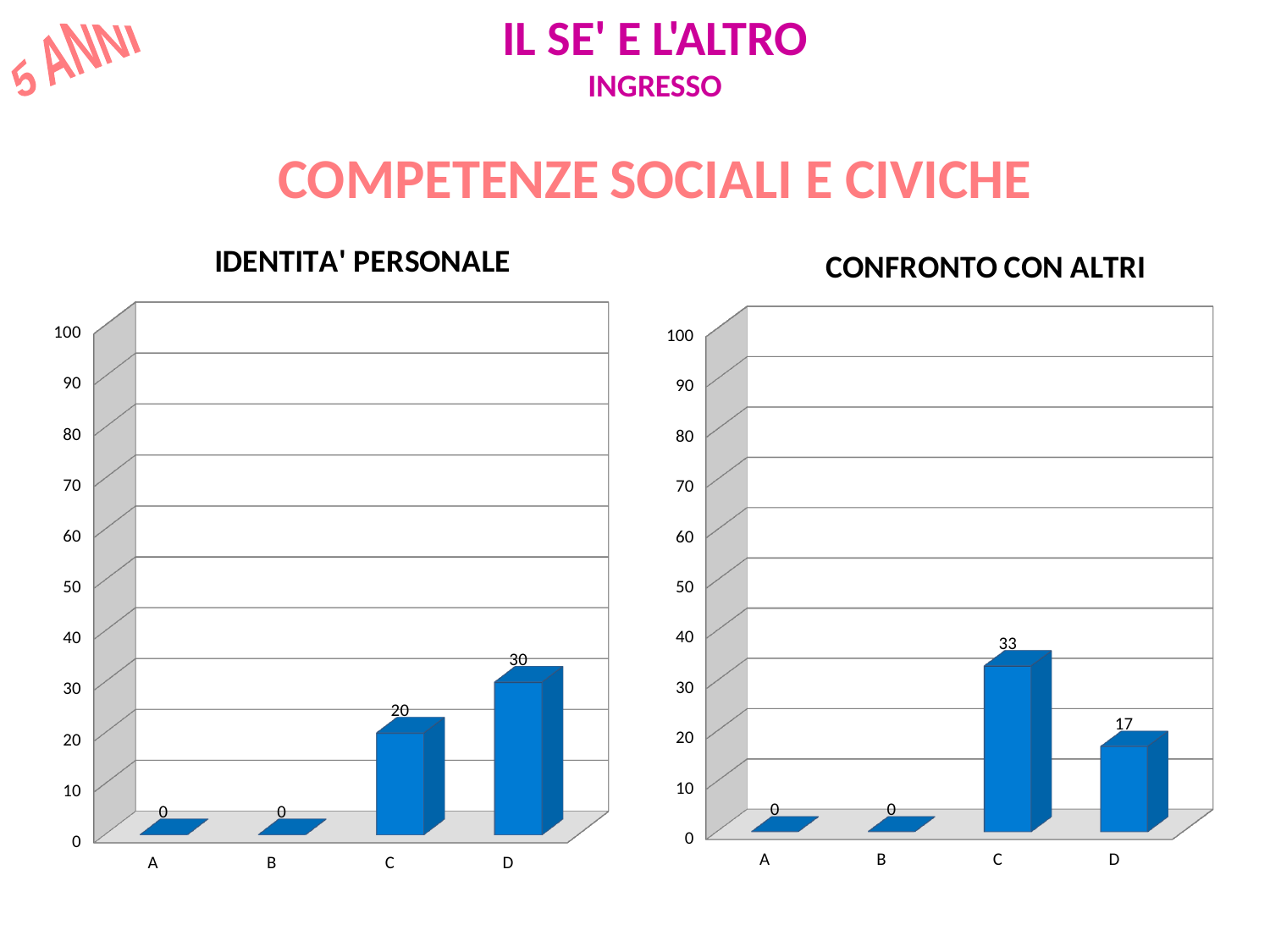
In the IDENTITA' PERSONALE chart, which category has the highest value? D In the CONFRONTO CON ALTRI chart, what is the difference between the values for C and D? 16 In the CONFRONTO CON ALTRI chart, what is the value for D? 17 In the IDENTITA' PERSONALE chart, what is the value for D? 30 In the CONFRONTO CON ALTRI chart, which is larger, the value for C or the value for D? C How many categories are shown on the x axis of the IDENTITA' PERSONALE chart? 4 What kind of chart is the CONFRONTO CON ALTRI chart? Bar chart In the IDENTITA' PERSONALE chart, what is the value for A? 0 In the CONFRONTO CON ALTRI chart, which category has the highest value? C In the IDENTITA' PERSONALE chart, what is the difference between the values for D and C? 10 In the IDENTITA' PERSONALE chart, what is the value for C? 20 In the CONFRONTO CON ALTRI chart, what is the value for C? 33